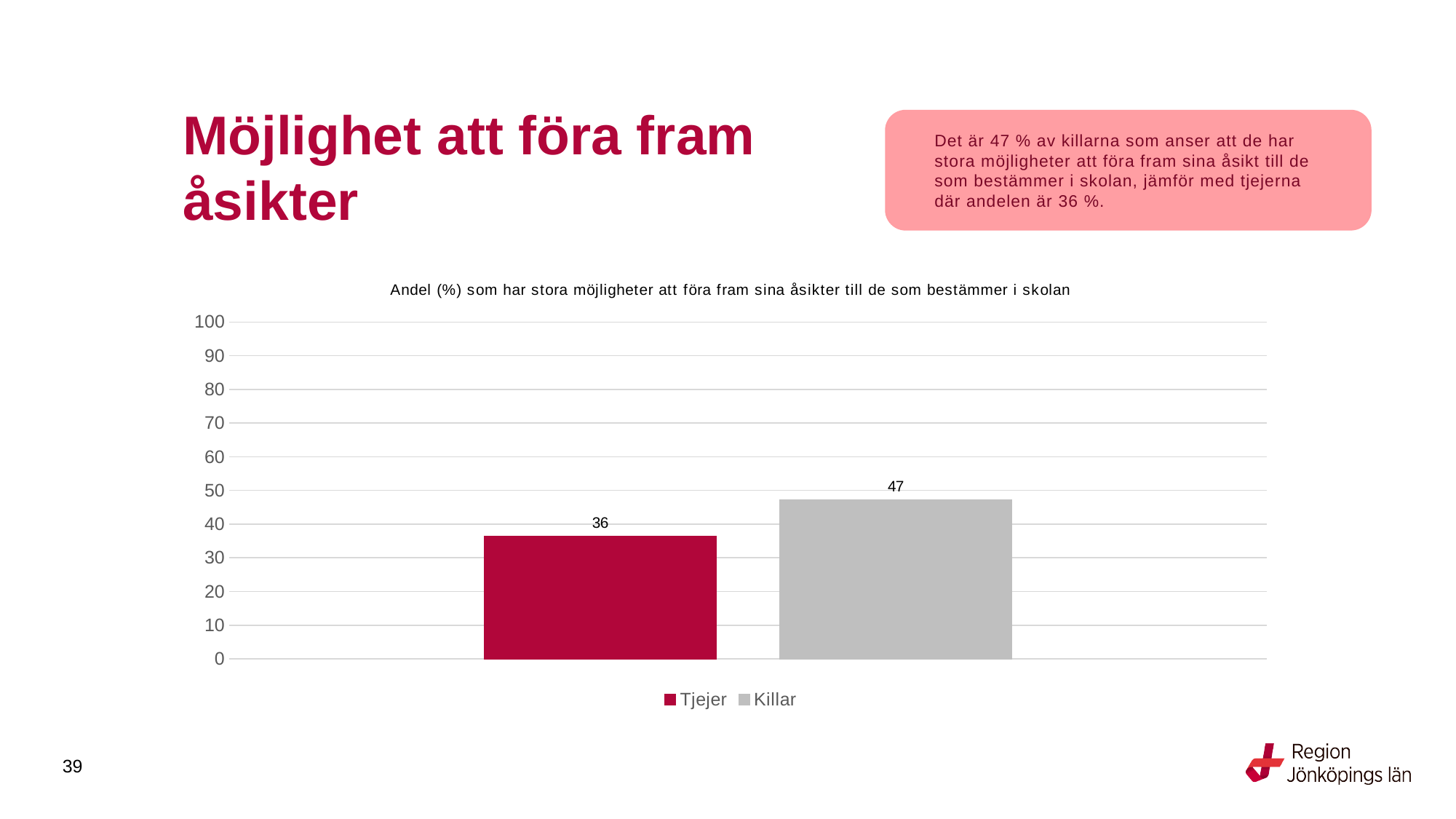
How many bars are plotted in the chart? 2 What is the difference between the values for Killar and Tjejer? 11 Which series has the lowest value? Tjejer Is the value for Killar larger or smaller than the value for Tjejer? larger Which series has the highest value, Tjejer or Killar? Killar What kind of chart is shown on the slide? bar chart What is the value for Tjejer? 36 Is the value for Killar greater or less than 50? less How many series does the legend list? 2 What is the value for Killar? 47 Is the value for Tjejer greater or less than 40? less What colour is the bar for Tjejer? dark red